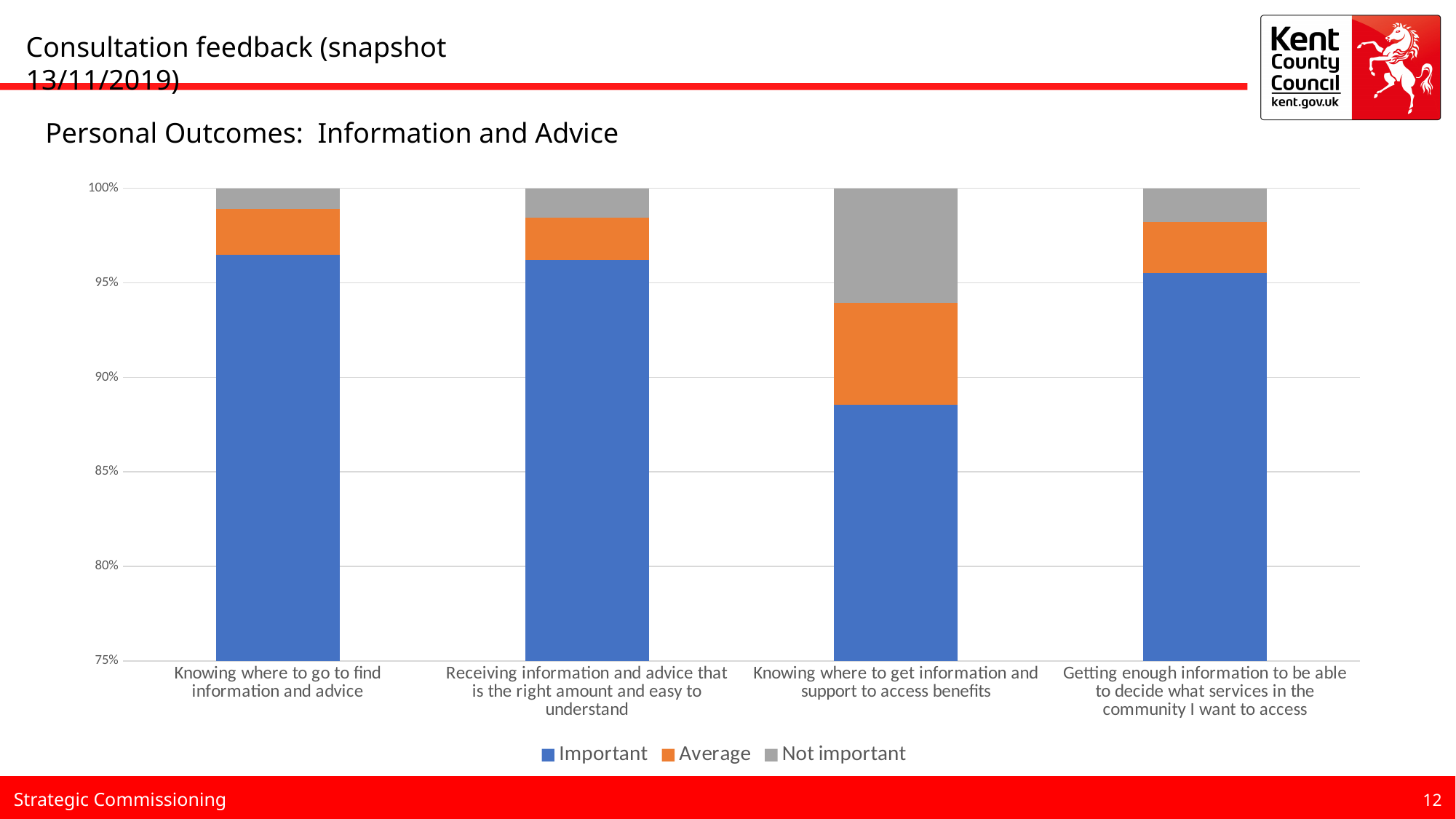
Which category has the largest 'Average' segment? Knowing where to get information and support to access benefits Is the 'Important' value for 'Knowing where to go to find information and advice' greater or less than 95%? greater Which category has the largest 'Not important' segment? Knowing where to get information and support to access benefits What are the three series listed in the chart's legend? Important, Average, Not important Which has a larger 'Important' share: 'Knowing where to go to find information and advice' or 'Knowing where to get information and support to access benefits'? Knowing where to go to find information and advice Is the 'Important' value for 'Knowing where to get information and support to access benefits' greater or less than 90%? less What is the lowest value shown on the chart's vertical axis? 75% Which category has the lowest share of 'Important' responses? Knowing where to get information and support to access benefits What kind of chart is shown on the slide? Stacked bar chart How many categories are shown on the x axis of the chart? 4 How many series does the chart's legend list? 3 Is the 'Important' value for 'Getting enough information to be able to decide what services in the community I want to access' greater or less than 90%? greater